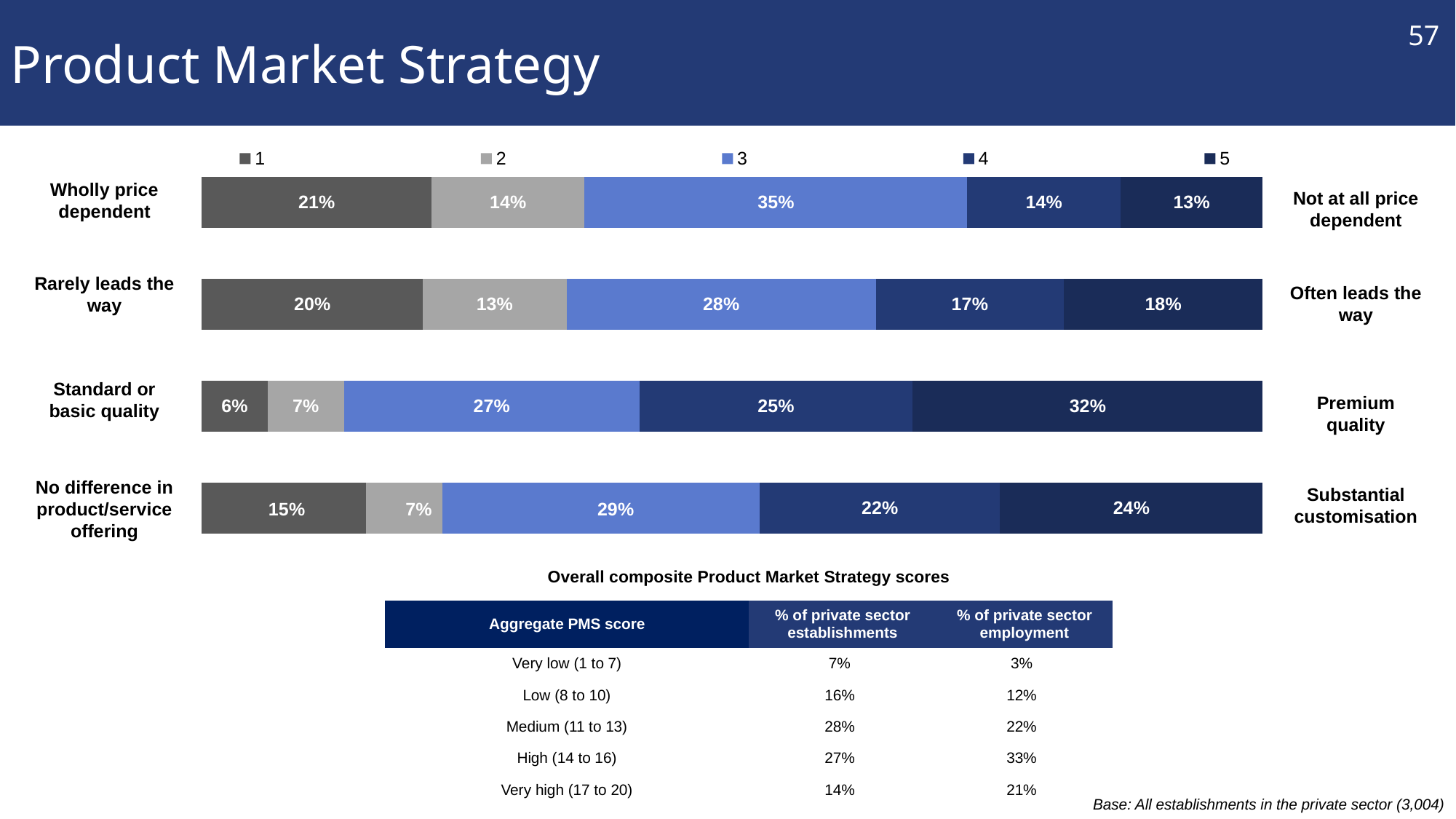
In the stacked bar chart, which series has the largest segment in the 'No difference in product/service offering / Substantial customisation' bar? 3 In the stacked bar chart, what is the value of series 3 in the 'Wholly price dependent / Not at all price dependent' bar? 35% In the stacked bar chart, what is the value of series 5 in the 'Standard or basic quality / Premium quality' bar? 32% What kind of chart is shown at the top of the slide? Stacked bar chart In the stacked bar chart, what is the difference between the series 5 and series 1 values in the 'Standard or basic quality / Premium quality' bar? 26 percentage points How many stacked bars are shown in the chart? 4 In the stacked bar chart, what is the difference between the series 3 value in the 'Wholly price dependent' bar and the series 3 value in the 'Rarely leads the way' bar? 7 percentage points In the stacked bar chart, what is the value of series 1 in the 'Rarely leads the way / Often leads the way' bar? 20% In the stacked bar chart, which series has the smallest segment in the 'Standard or basic quality / Premium quality' bar? 1 In the stacked bar chart, what is the value of series 2 in the 'No difference in product/service offering / Substantial customisation' bar? 7% How many series does the legend of the stacked bar chart list? 5 In the stacked bar chart, which is larger in the 'Rarely leads the way / Often leads the way' bar: series 4 or series 5? 5